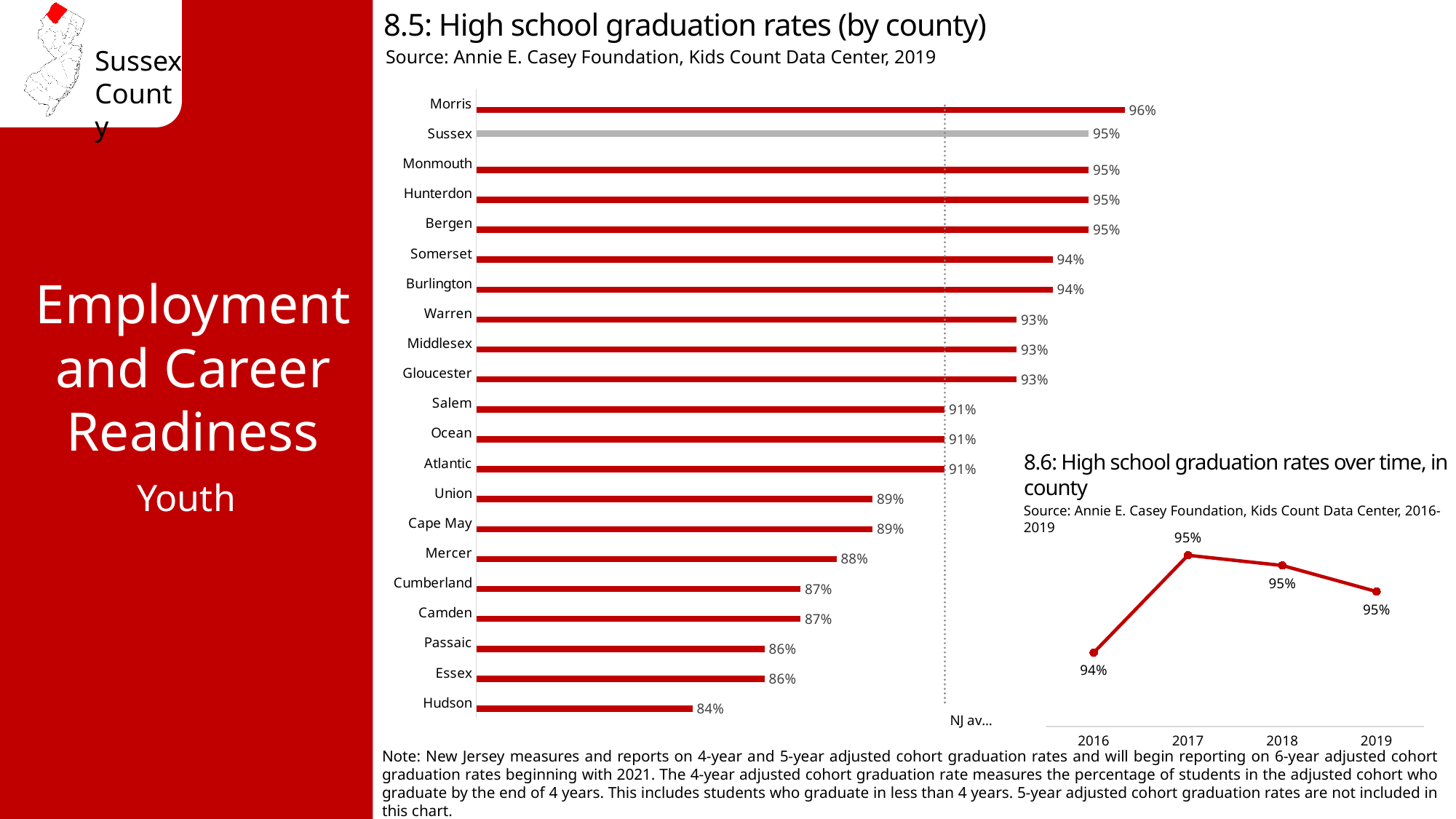
In chart 8.5 (High school graduation rates by county), what is the graduation rate for Sussex? 95% In chart 8.5 (High school graduation rates by county), which has a higher graduation rate, Somerset or Salem? Somerset In chart 8.5 (High school graduation rates by county), what is the graduation rate for Morris? 96% In chart 8.5 (High school graduation rates by county), how many counties are shown? 21 In chart 8.5 (High school graduation rates by county), what is the difference between the graduation rates of Morris and Hudson? 12 percentage points In chart 8.5 (High school graduation rates by county), what is the graduation rate for Mercer? 88% In chart 8.5 (High school graduation rates by county), which county has the lowest graduation rate? Hudson In chart 8.6 (High school graduation rates over time, in county), how many years are plotted? 4 In chart 8.6 (High school graduation rates over time, in county), what was the graduation rate in 2016? 94% In chart 8.5 (High school graduation rates by county), what is the graduation rate for Hudson? 84% In chart 8.5 (High school graduation rates by county), which county has the highest graduation rate? Morris What kind of chart is chart 8.5 (High school graduation rates by county)? Bar chart